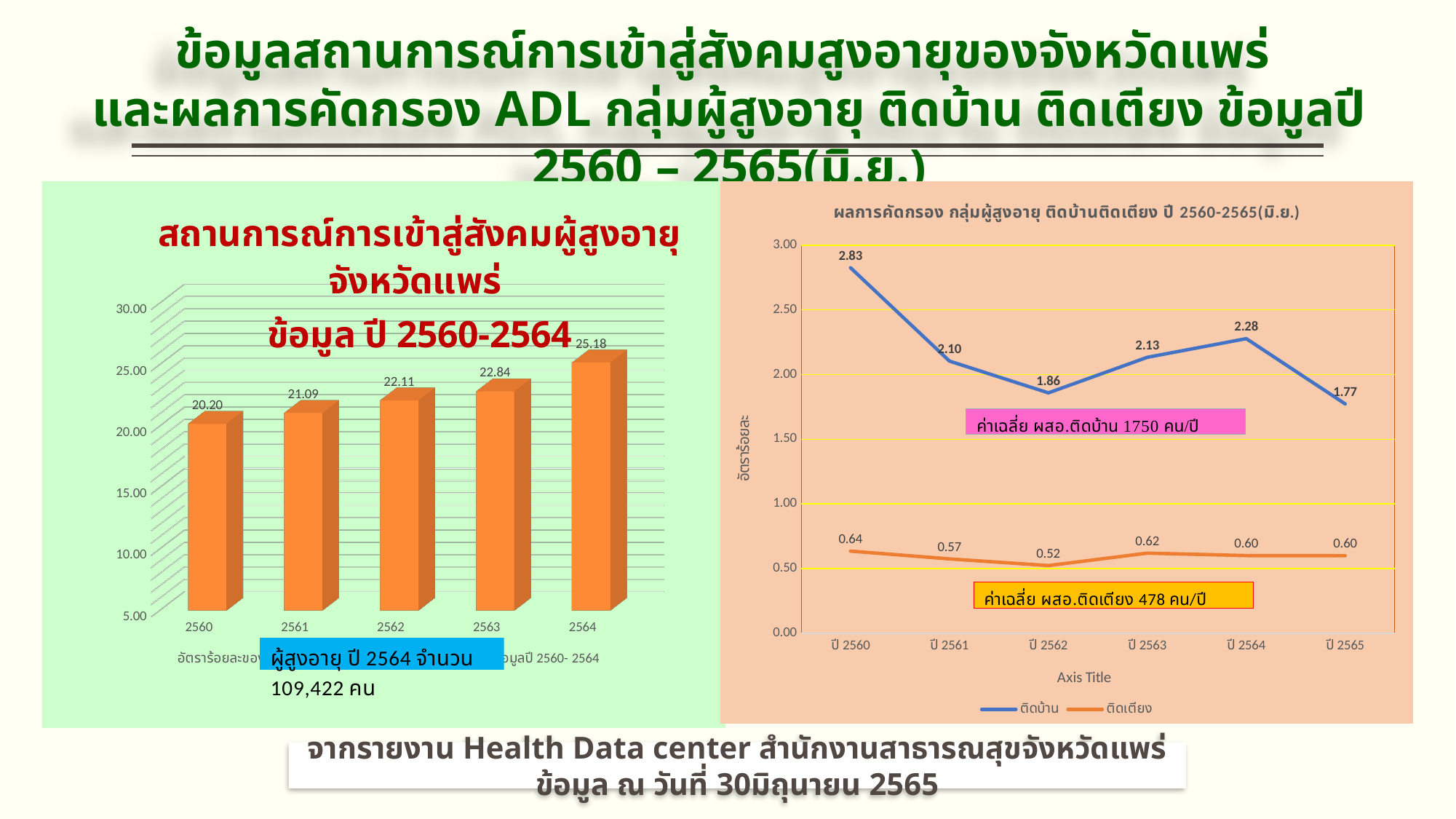
In the right line chart, what is the value of ติดบ้าน for ปี 2560? 2.83 How many bars are in the left bar chart? 5 In the left bar chart, what is the value for 2560? 20.20 In the right line chart, which year has the lowest ติดบ้าน value? ปี 2565 What kind of chart is the chart on the left? bar chart In the left bar chart, which year has the highest value? 2564 In the right line chart, what is the difference between the ติดบ้าน values for ปี 2564 and ปี 2565? 0.51 In the right line chart, what is the value of ติดเตียง for ปี 2562? 0.52 In the left bar chart, what is the value for 2564? 25.18 In the left bar chart, do the values rise or fall from 2560 to 2564? rise In the left bar chart, what is the difference between the values for 2564 and 2560? 4.98 How many series does the legend of the right line chart list? 2